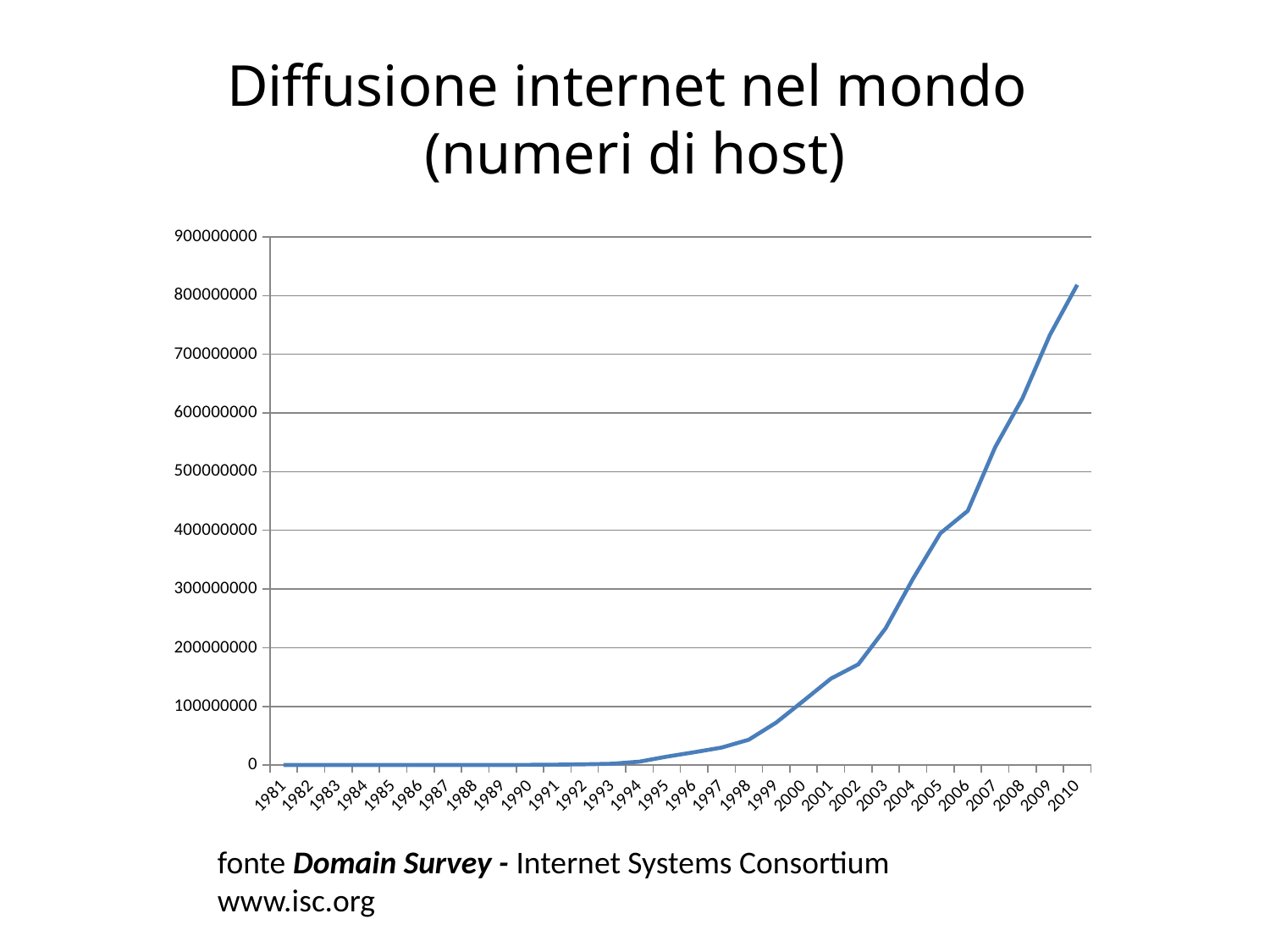
Is the value for 2007 greater or less than 500000000? greater Is the value for 2010 greater or less than 700000000? greater What is the highest value shown on the y axis? 900000000 Which year has the larger value, 2005 or 2010? 2010 How many years are plotted along the x axis? 30 Which year has the highest number of hosts? 2010 Do the values rise or fall from 1981 to 2010? rise What is the title of the chart on the slide? Diffusione internet nel mondo (numeri di host) Is the value for 2002 greater or less than 200000000? less What kind of chart is shown on the slide? line chart